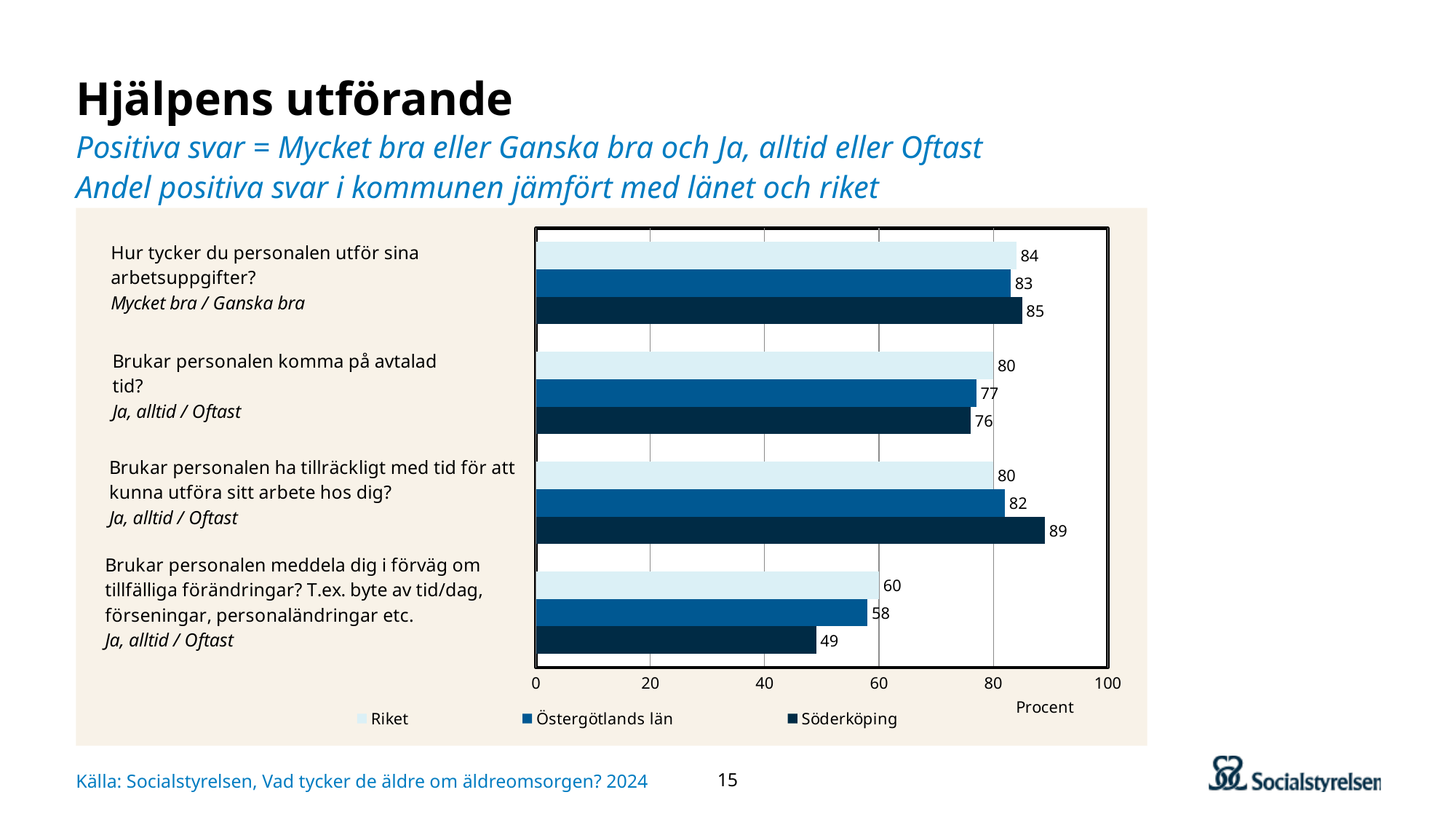
What unit is shown on the x axis of the chart? Procent What is the difference between Söderköping and Riket for the question "Brukar personalen meddela dig i förväg om tillfälliga förändringar?"? 11 What is the value for Östergötlands län for the question "Brukar personalen komma på avtalad tid?"? 77 How many questions (categories) are shown in the chart? 4 What is the value for Riket for the question "Brukar personalen meddela dig i förväg om tillfälliga förändringar?"? 60 For the question "Brukar personalen komma på avtalad tid?", which is larger: Riket or Söderköping? Riket Which question has the highest value for Söderköping? Brukar personalen ha tillräckligt med tid för att kunna utföra sitt arbete hos dig? Which question has the lowest value for Söderköping? Brukar personalen meddela dig i förväg om tillfälliga förändringar? Is the value for Söderköping for the question "Brukar personalen meddela dig i förväg om tillfälliga förändringar?" greater or less than 60? less How many series does the legend list? 3 What type of chart is shown on the slide? Bar chart What is the value for Söderköping for the question "Brukar personalen ha tillräckligt med tid för att kunna utföra sitt arbete hos dig?"? 89